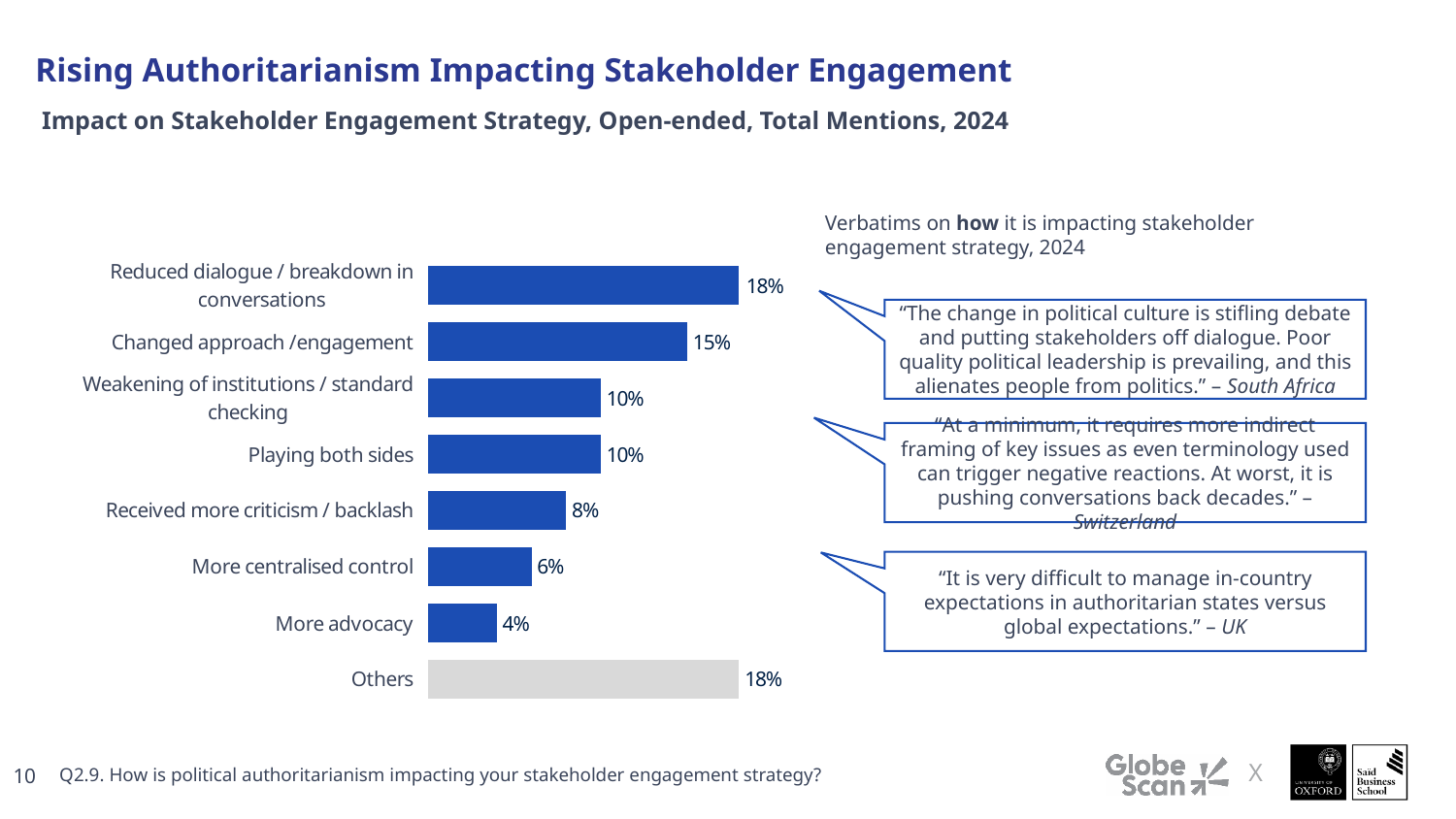
How many categories are shown in the bar chart? 8 What is the value for "More centralised control"? 6% What is the difference between "Received more criticism / backlash" and "More advocacy"? 4% What type of chart is used on this slide? Bar chart Which bar in the chart is coloured grey rather than blue? Others What is the value for "Changed approach /engagement"? 15% Which category has the lowest value in the chart? More advocacy What is the value for "Others"? 18% What percentage of mentions is shown for "Reduced dialogue / breakdown in conversations"? 18% What is the difference between the values for "Changed approach /engagement" and "Playing both sides"? 5% Which is larger: the value for "Weakening of institutions / standard checking" or the value for "More centralised control"? Weakening of institutions / standard checking What percentage is shown for "Received more criticism / backlash"? 8%